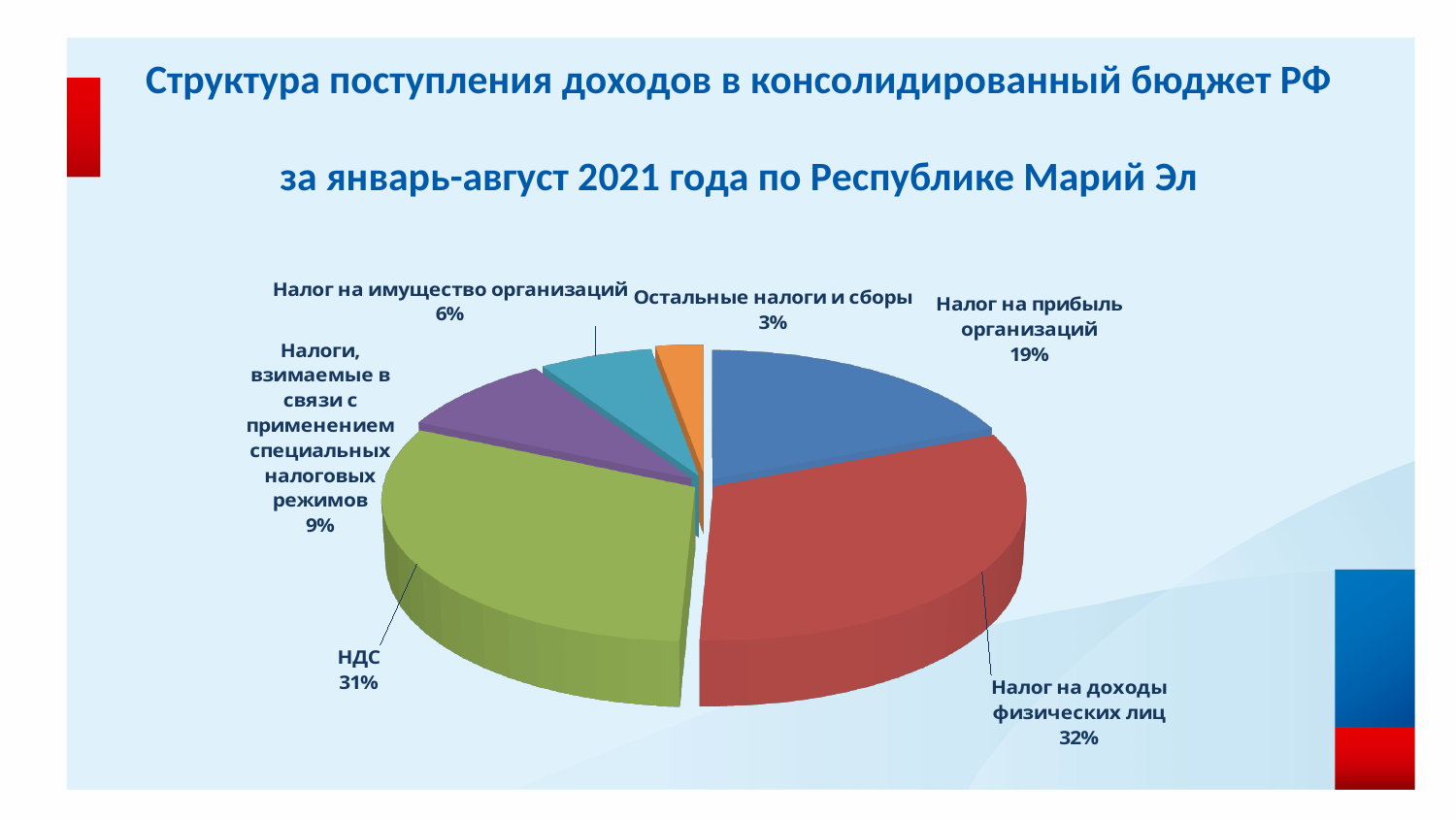
Which is larger: the share for НДС or the share for Налог на прибыль организаций? НДС What is the difference in percentage points between the share for Налог на прибыль организаций and the share for Налог на имущество организаций? 13 percentage points What share of the pie is labelled for НДС? 31% What kind of chart is shown on the slide? Pie chart Which category has the largest share of the pie? Налог на доходы физических лиц Which category has the smallest share of the pie? Остальные налоги и сборы What share of the pie is labelled for Налоги, взимаемые в связи с применением специальных налоговых режимов? 9% What share of the pie is labelled for Налог на прибыль организаций? 19% How many slices does the pie chart have? 6